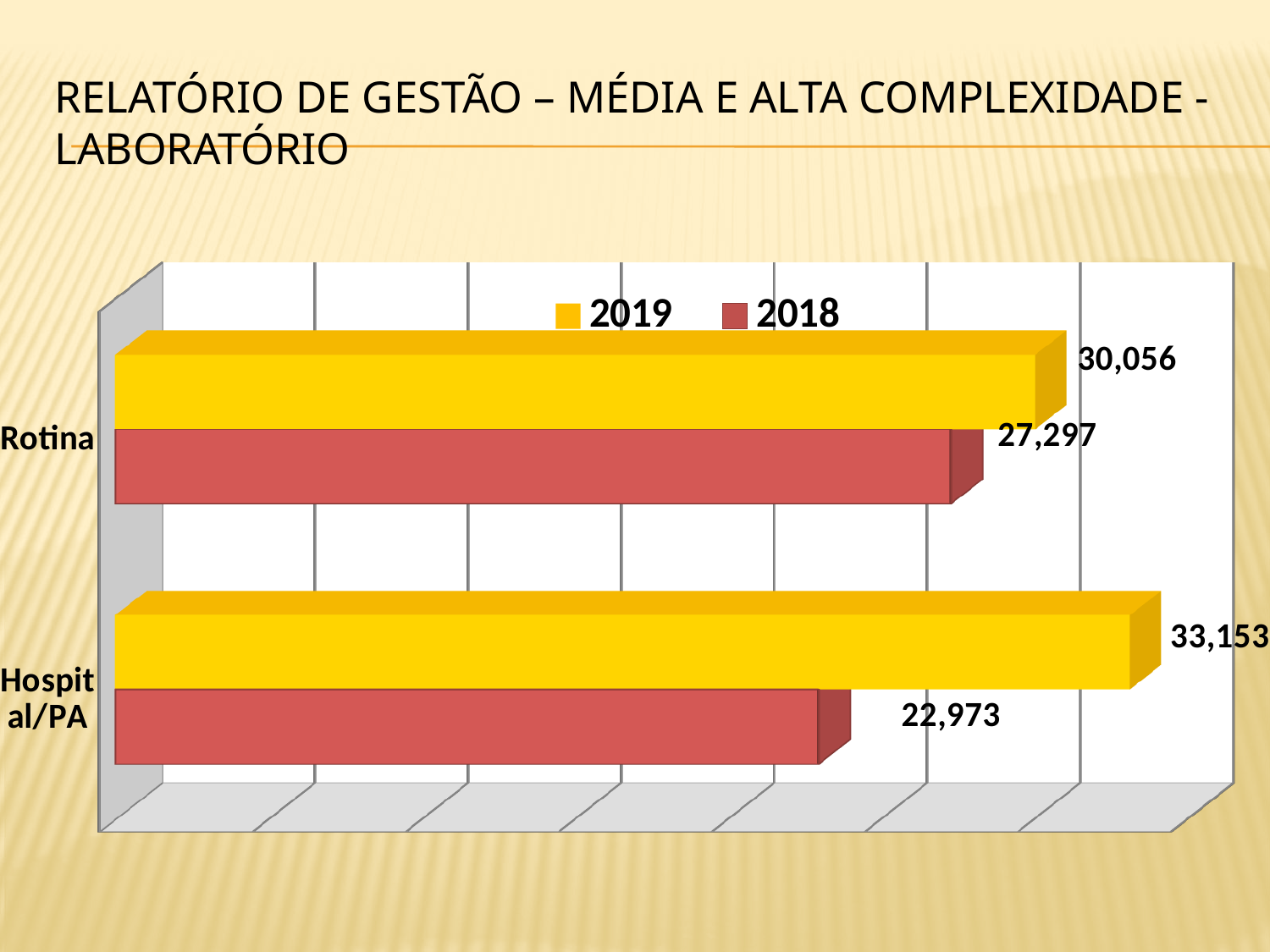
What kind of chart is shown on the slide? Bar chart What is the 2019 value for Hospital/PA? 33,153 What is the 2019 value for Rotina? 30,056 Which category has the highest 2019 value? Hospital/PA Which is larger for Rotina, the 2019 value or the 2018 value? 2019 Which category has the lowest 2018 value? Hospital/PA How many categories are shown on the chart? 2 What is the 2018 value for Hospital/PA? 22,973 What is the difference between the 2019 and 2018 values for Hospital/PA? 10,180 How many series does the legend list? 2 What is the difference between the 2019 and 2018 values for Rotina? 2,759 What is the 2018 value for Rotina? 27,297